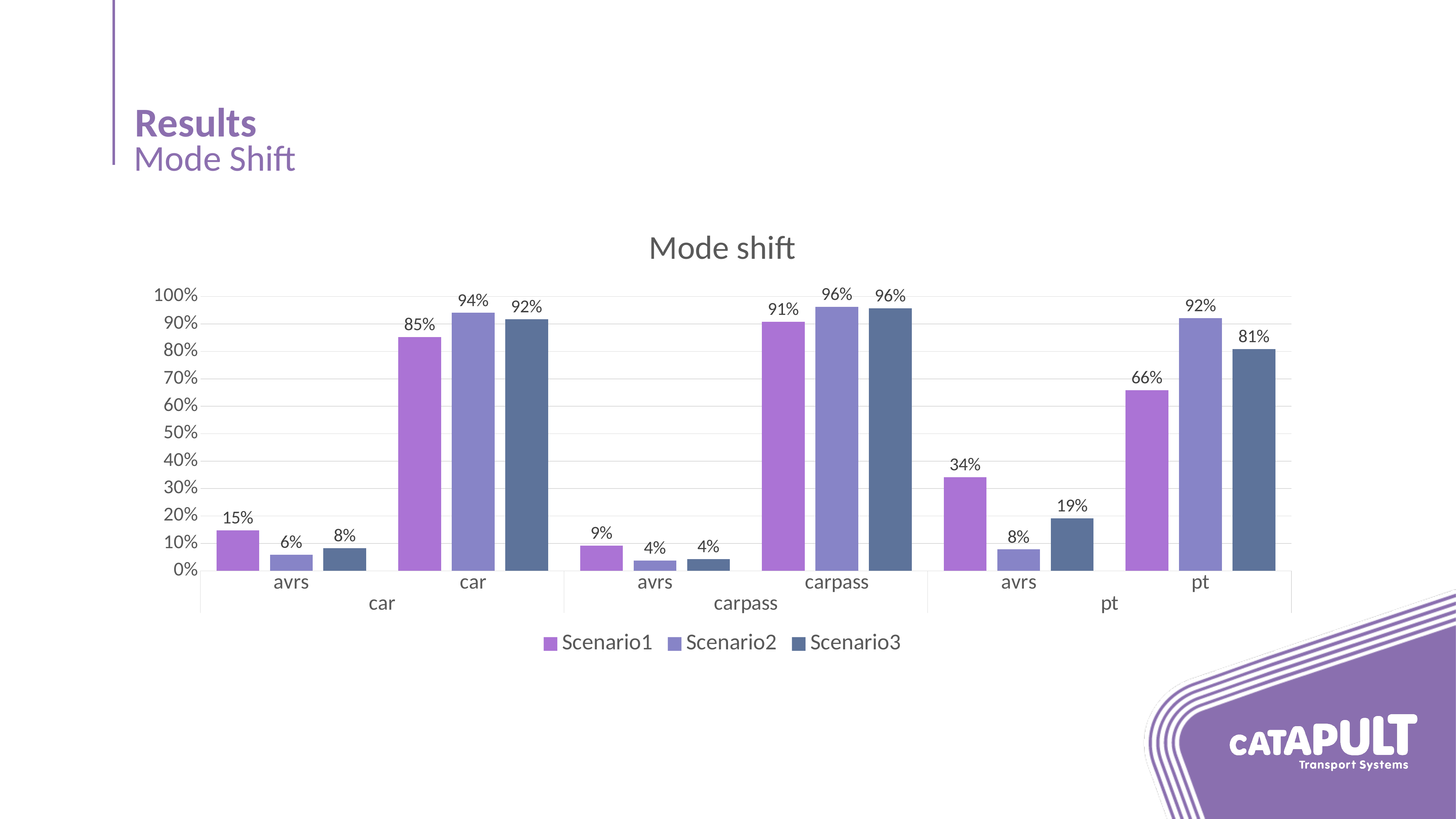
Which scenario has the highest value for avrs in the pt group? Scenario1 How many series does the legend list? 3 What is the Scenario1 value for avrs in the car group? 15% What is the Scenario3 value for pt in the pt group? 81% What kind of chart is shown on the slide? Bar chart What is the difference between the Scenario1 values for avrs in the car group and avrs in the carpass group? 6% What is the Scenario1 value for avrs in the pt group? 34% What is the title of the chart? Mode shift Which is larger: the Scenario1 value for car in the car group or the Scenario3 value for car in the car group? Scenario3 Which scenario has the lowest value for pt in the pt group? Scenario1 What is the difference between the Scenario2 and Scenario1 values for pt in the pt group? 26% What is the Scenario2 value for car in the car group? 94%